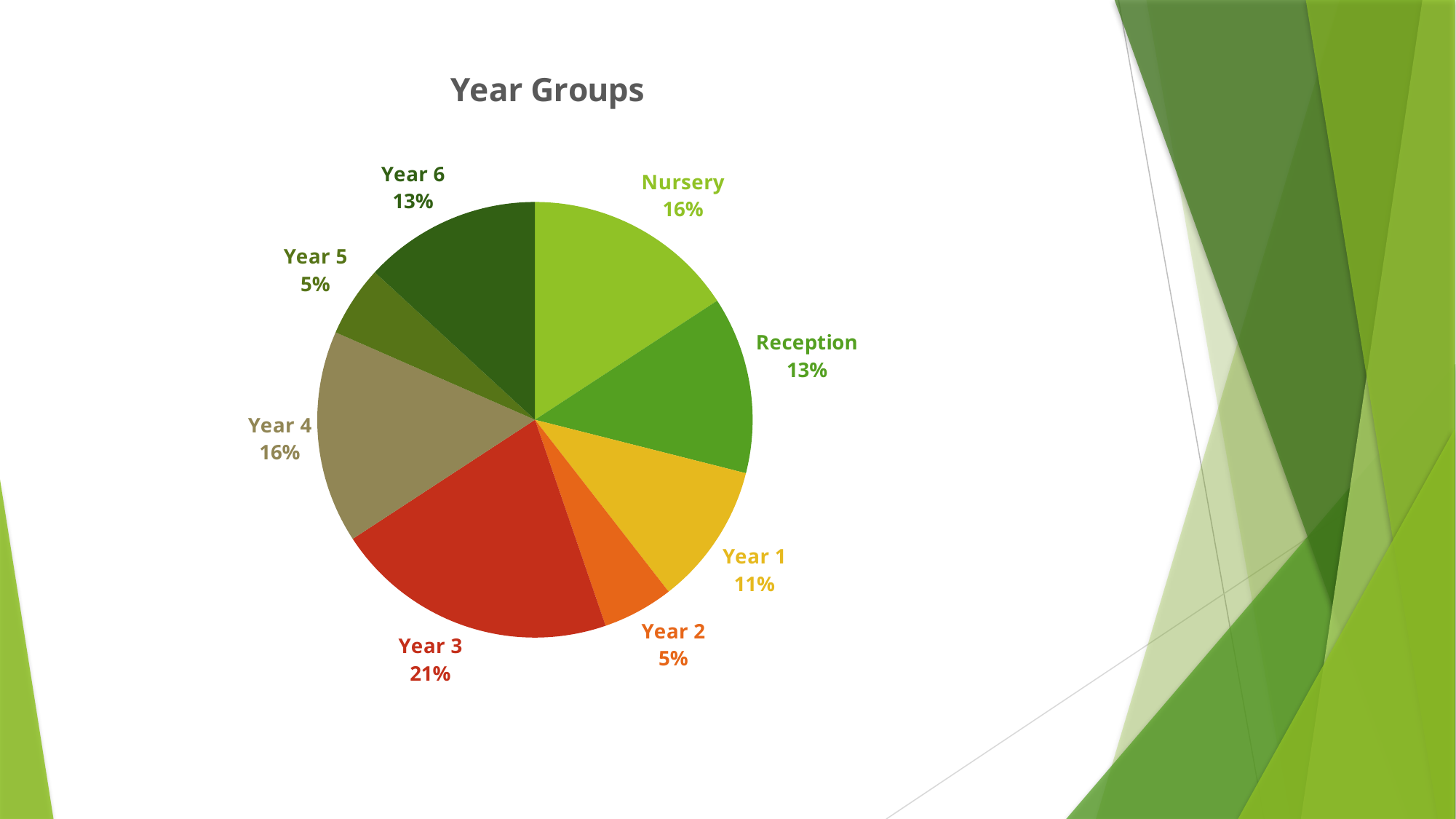
What is the difference between the Year 3 share and the Year 4 share? 5% What kind of chart is shown on the slide? pie chart Which year group has the largest slice of the pie? Year 3 What is the difference between the Nursery share and the Year 2 share? 11% What is the value shown for Nursery? 16% Which year groups share the smallest slice of the pie? Year 5 and Year 2 Which is larger, the share for Reception or the share for Year 1? Reception What is the title of the chart? Year Groups What share of the pie does Year 3 represent? 21% What is the value shown for Year 6? 13% What is the value shown for Year 1? 11% How many slices does the pie chart have? 8